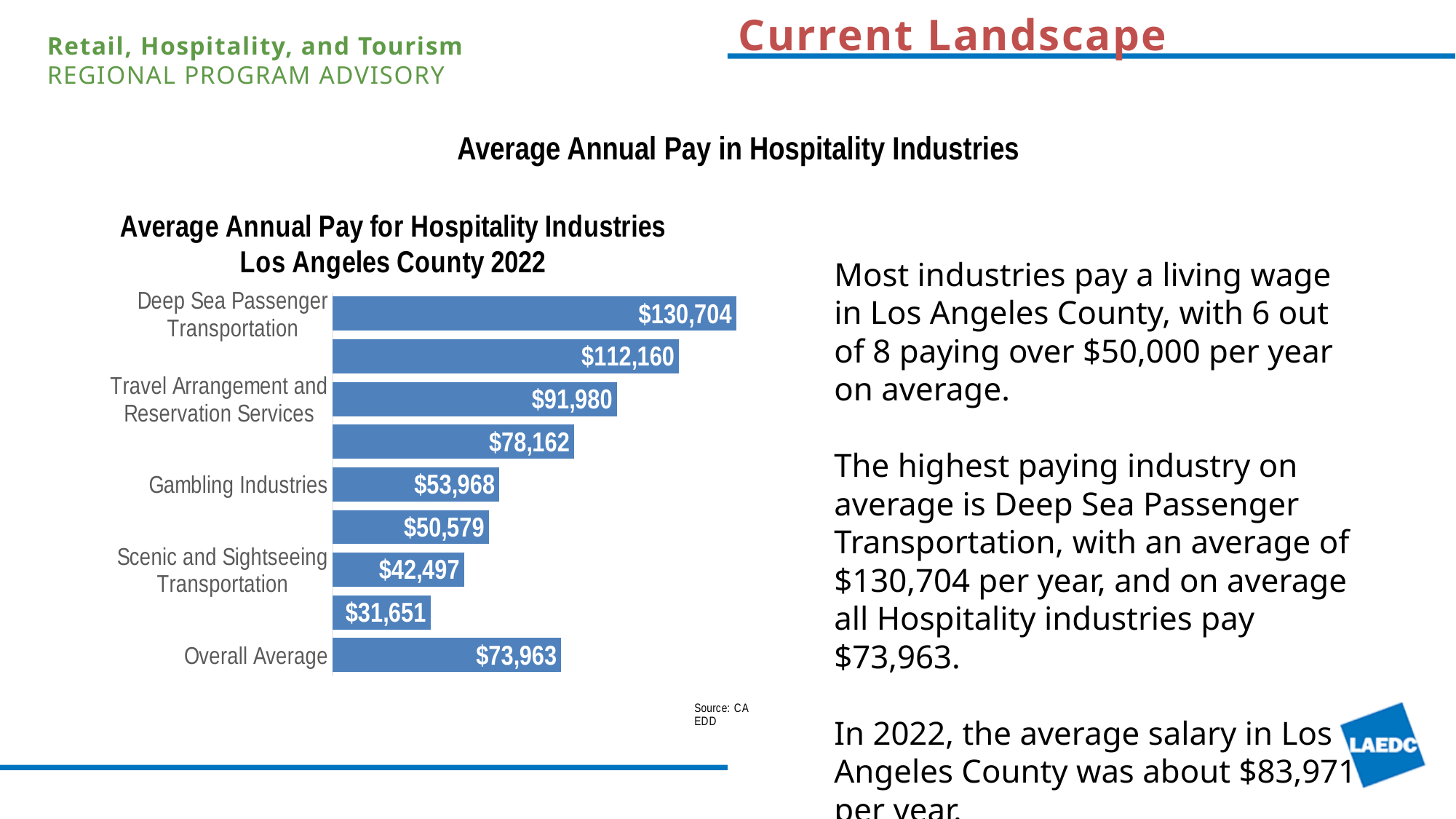
What is the average annual pay for Scenic and Sightseeing Transportation? $42,497 What is the difference between the average annual pay for Deep Sea Passenger Transportation and Travel Arrangement and Reservation Services? $38,724 How much higher is the average annual pay for Gambling Industries than for Scenic and Sightseeing Transportation? $11,471 What is the Overall Average annual pay shown in the chart? $73,963 What type of chart is used to show average annual pay in hospitality industries? Bar chart What is the lowest value shown on any bar in the chart? $31,651 What is the average annual pay for Deep Sea Passenger Transportation? $130,704 What is the average annual pay for Gambling Industries? $53,968 Which has a higher average annual pay: Gambling Industries or the Overall Average? Overall Average How many bars are shown in the chart? 9 Which industry has the highest average annual pay in the chart? Deep Sea Passenger Transportation What is the average annual pay for Travel Arrangement and Reservation Services? $91,980